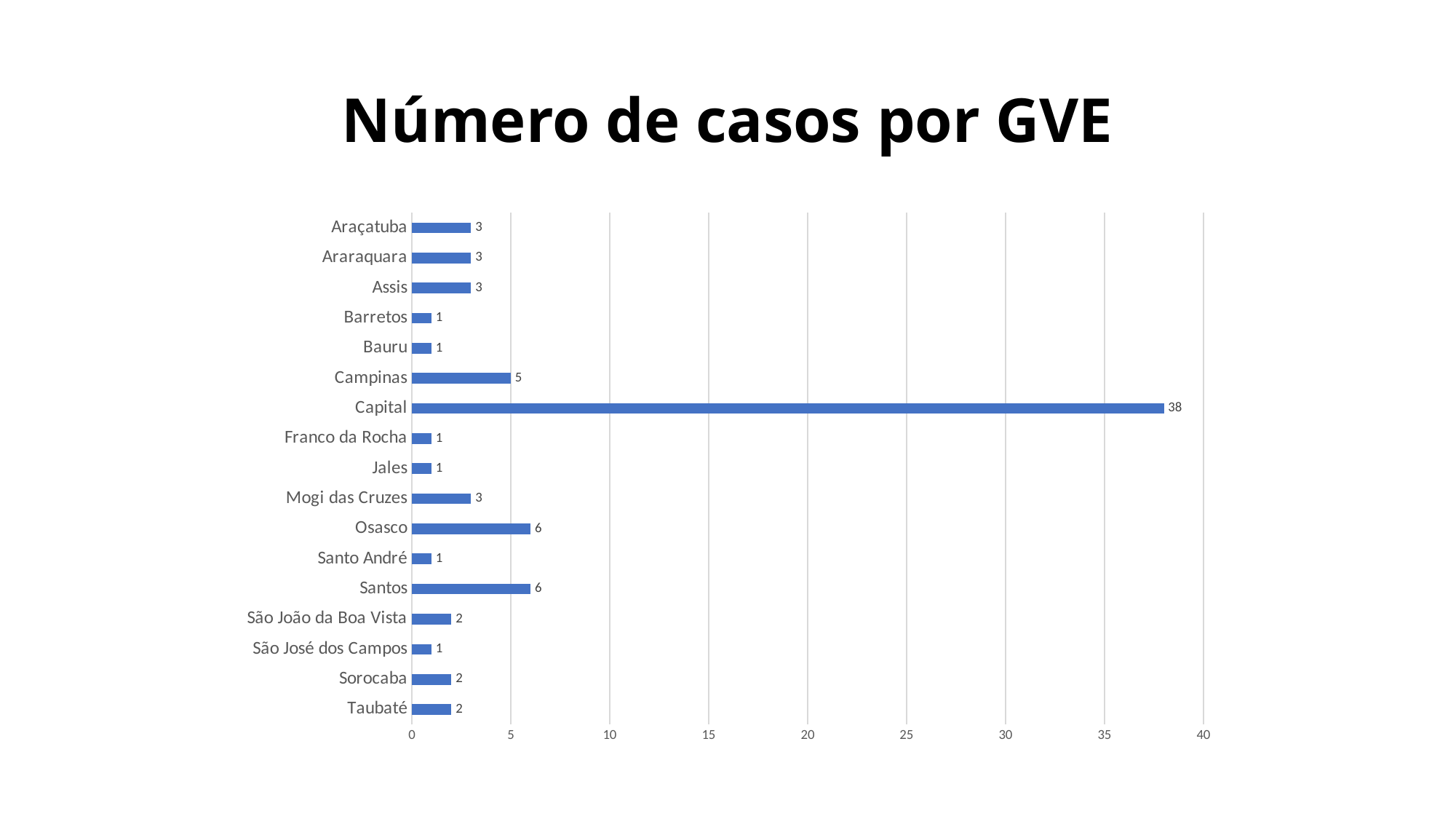
What is the value for São João da Boa Vista? 2 Which category has the highest value? Capital What kind of chart is shown on the slide? Bar chart Is the value for Capital greater or less than 35? greater What is the difference between the values for Capital and Santos? 32 What is the value for Osasco? 6 What is the difference between the values for Osasco and Taubaté? 4 What is the value for Campinas? 5 How many categories are shown on the chart? 17 Which is larger, the value for Campinas or the value for Mogi das Cruzes? Campinas What is the title of the chart? Número de casos por GVE What is the value for Capital? 38